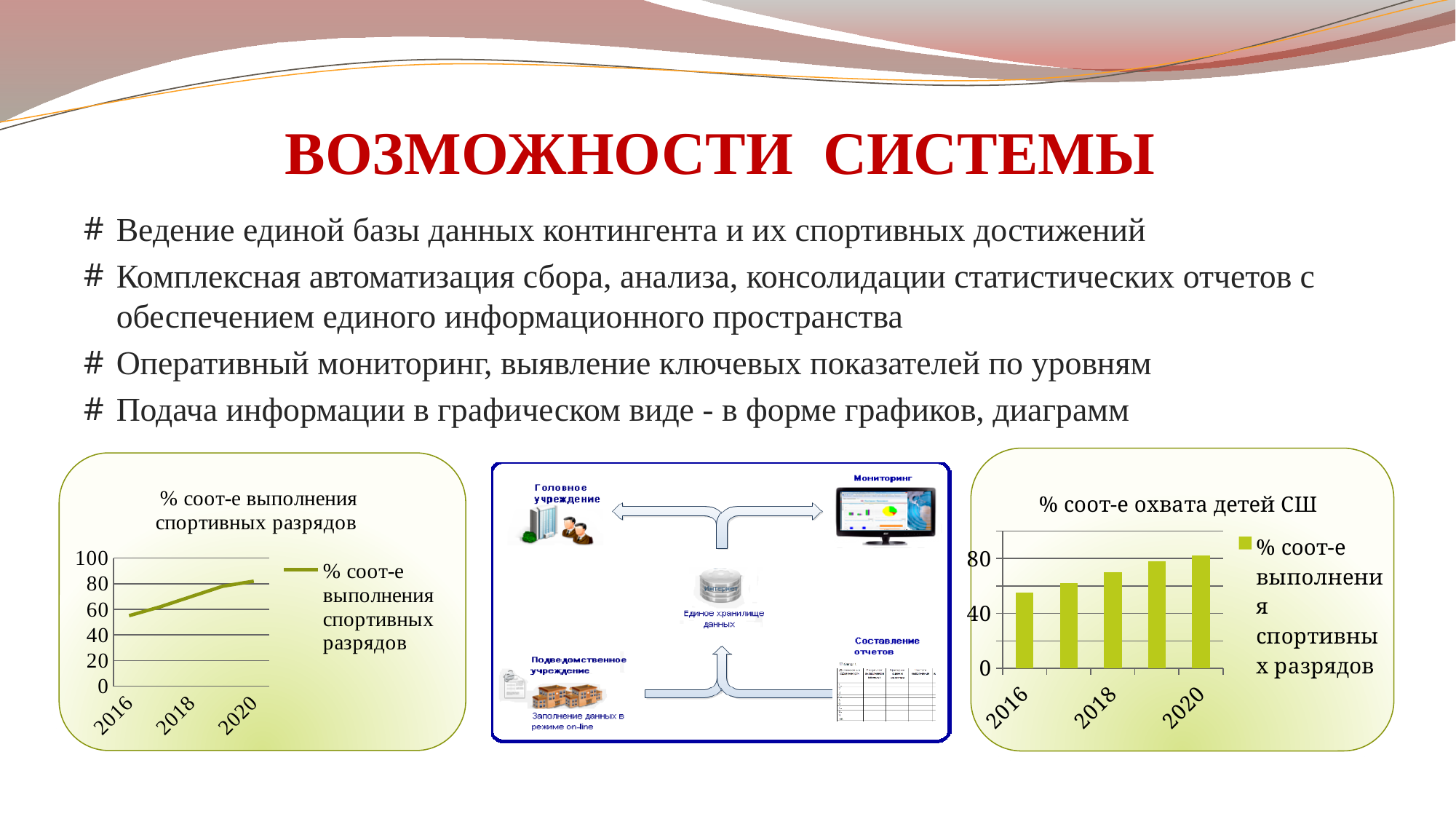
In the right chart "% соот-е охвата детей СШ", is the value for 2016 greater or less than 40? greater In the left chart "% соот-е выполнения спортивных разрядов", do the values rise or fall from 2016 to 2020? rise In the right chart "% соот-е охвата детей СШ", which year has the lowest bar? 2016 What kind of chart is the left chart titled "% соот-е выполнения спортивных разрядов"? line chart In the right chart "% соот-е охвата детей СШ", which year has the highest bar? 2020 How many series does the legend of the left chart "% соот-е выполнения спортивных разрядов" list? 1 In the right chart "% соот-е охвата детей СШ", which is larger, the value for 2016 or the value for 2020? 2020 In the left chart "% соот-е выполнения спортивных разрядов", is the value for 2020 greater or less than 60? greater What kind of chart is the right chart titled "% соот-е охвата детей СШ"? bar chart How many bars are plotted in the right chart "% соот-е охвата детей СШ"? 5 In the left chart "% соот-е выполнения спортивных разрядов", is the value for 2016 greater or less than 40? greater In the right chart "% соот-е охвата детей СШ", do the bars rise or fall from 2016 to 2020? rise